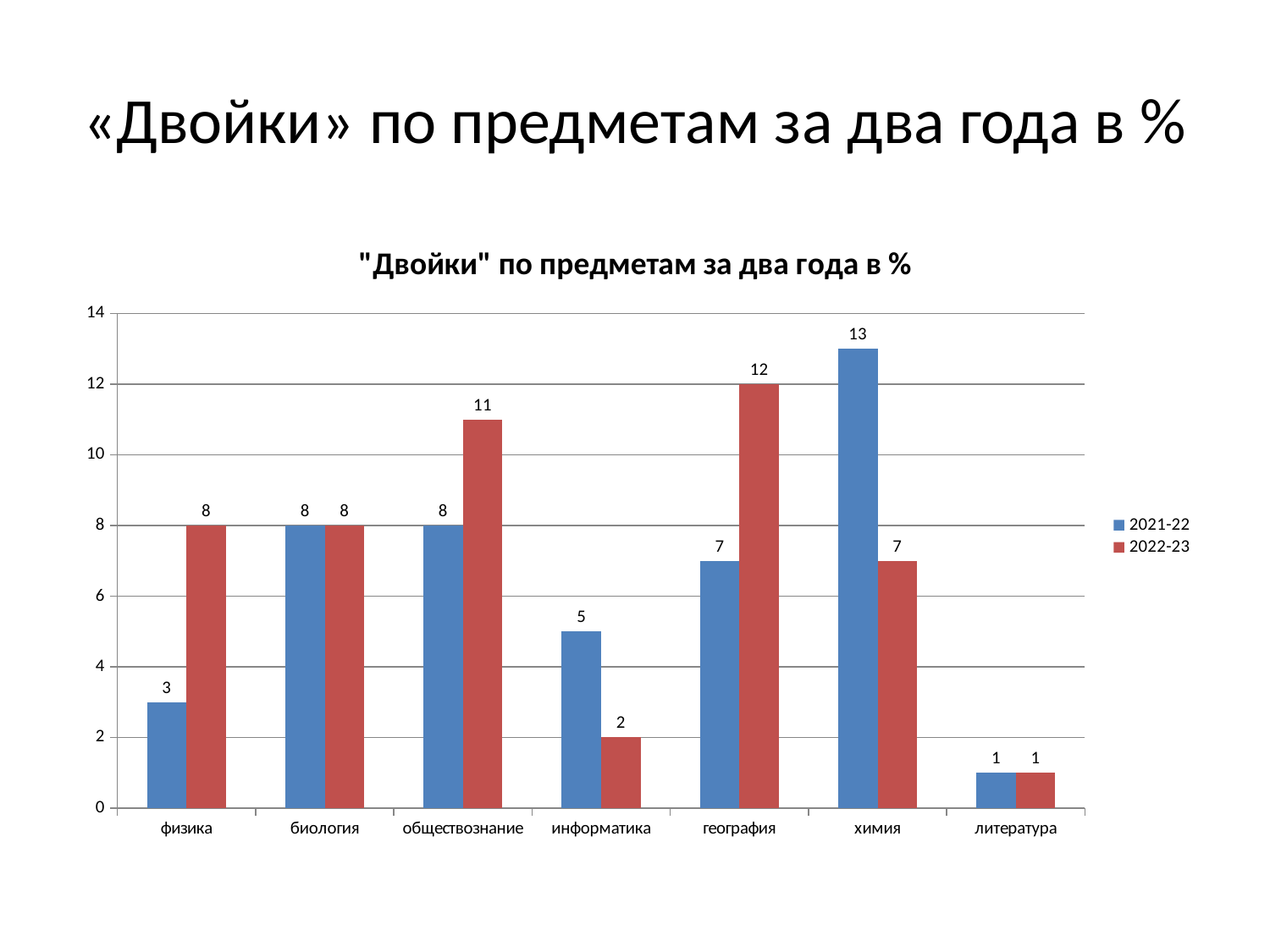
What is the title of the chart? "Двойки" по предметам за два года в % What is the value for информатика in the 2022-23 series? 2 Which category has the highest value in the 2021-22 series? химия How many series does the legend list? 2 What is the value for география in the 2022-23 series? 12 Which colour represents the 2022-23 series? red What is the difference between the 2022-23 and 2021-22 values for обществознание? 3 What kind of chart is shown on the slide? bar chart Which is larger for химия: the 2021-22 value or the 2022-23 value? 2021-22 How many categories are shown on the x axis? 7 Which category has the lowest value in the 2022-23 series? литература What is the value for физика in the 2021-22 series? 3